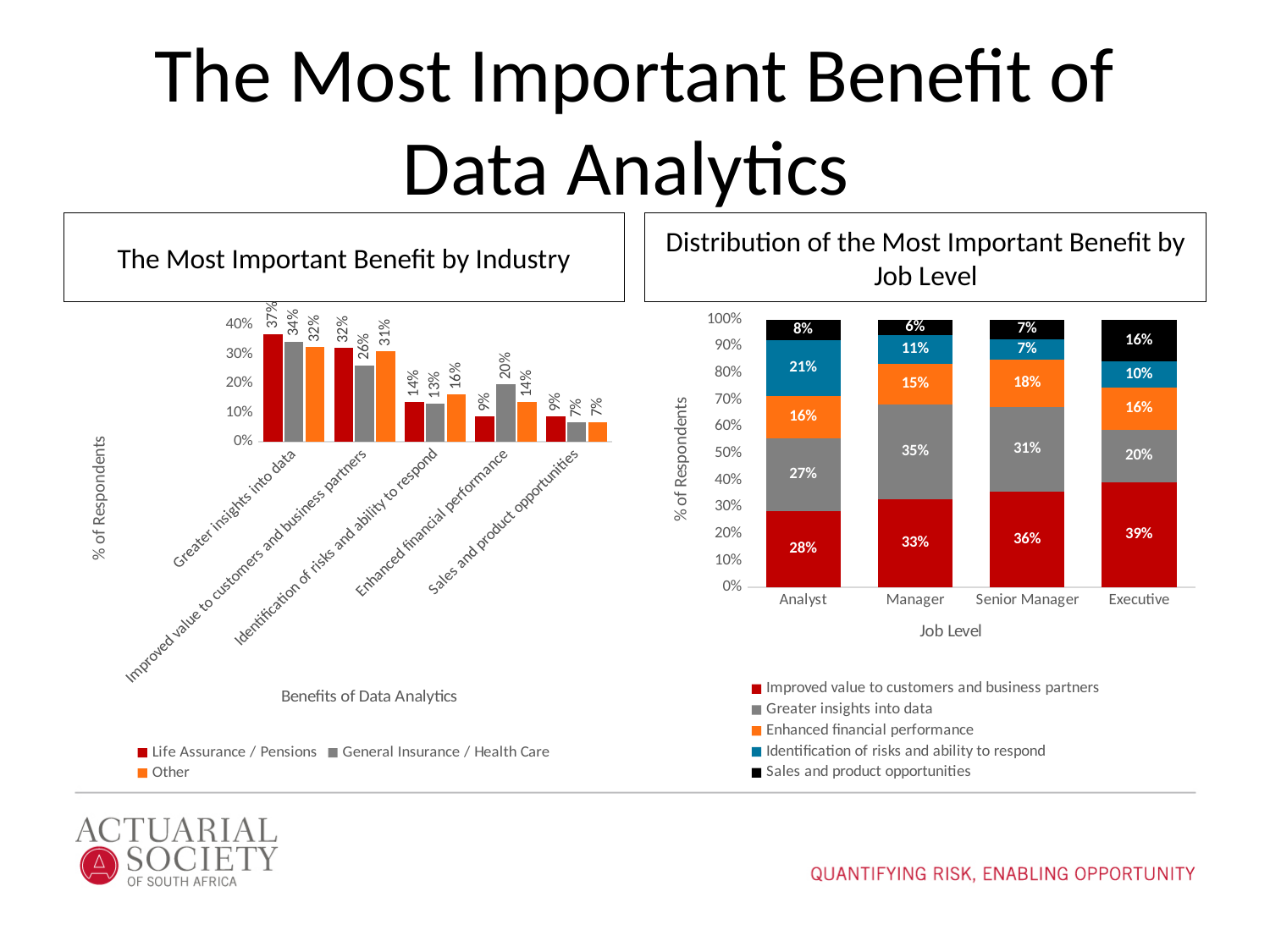
In the chart 'Distribution of the Most Important Benefit by Job Level', is the 'Improved value to customers and business partners' share larger for Analysts or for Senior Managers? Senior Managers In the chart 'Distribution of the Most Important Benefit by Job Level', what percentage of Executives chose 'Improved value to customers and business partners'? 39% In the chart 'The Most Important Benefit by Industry', what is the value for Life Assurance / Pensions for 'Greater insights into data'? 37% In the chart 'The Most Important Benefit by Industry', how many benefit categories are shown on the x axis? 5 In the chart 'The Most Important Benefit by Industry', which benefit has the highest value for Life Assurance / Pensions? Greater insights into data In the chart 'Distribution of the Most Important Benefit by Job Level', which job level has the highest share for 'Greater insights into data'? Manager What kind of chart is 'Distribution of the Most Important Benefit by Job Level'? Stacked bar chart In the chart 'The Most Important Benefit by Industry', what is the difference between the Life Assurance / Pensions and General Insurance / Health Care values for 'Improved value to customers and business partners'? 6% In the chart 'Distribution of the Most Important Benefit by Job Level', how does the share for 'Improved value to customers and business partners' change from Analyst to Executive? It rises In the chart 'The Most Important Benefit by Industry', how many series does the legend list? 3 In the chart 'Distribution of the Most Important Benefit by Job Level', what percentage of Analysts chose 'Identification of risks and ability to respond'? 21% In the chart 'The Most Important Benefit by Industry', what is the value for General Insurance / Health Care for 'Enhanced financial performance'? 20%